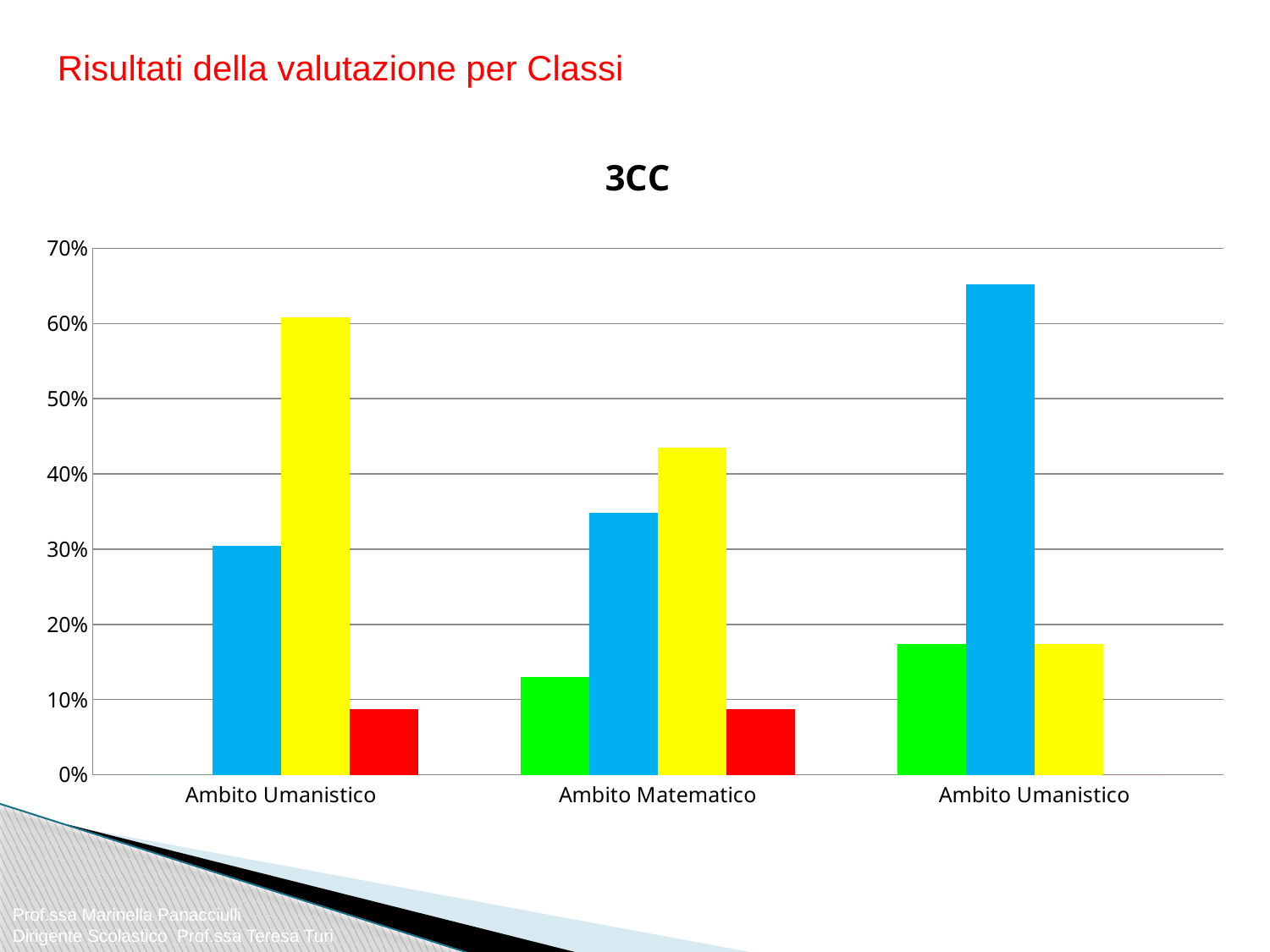
How many bars are in the Ambito Matematico group? 4 What kind of chart is shown on the slide? bar chart In the rightmost Ambito Umanistico group, which is larger, the blue bar or the yellow bar? the blue bar Is the green bar in the rightmost Ambito Umanistico group greater or less than 20%? less Is the blue bar in the rightmost Ambito Umanistico group greater or less than 60%? greater Which bar is the tallest in the whole chart? the blue bar in the rightmost Ambito Umanistico group In the Ambito Matematico group, which is larger, the yellow bar or the blue bar? the yellow bar Is the yellow bar in the first Ambito Umanistico group greater or less than 50%? greater What is the title of the chart? 3CC How many category groups are shown along the x axis? 3